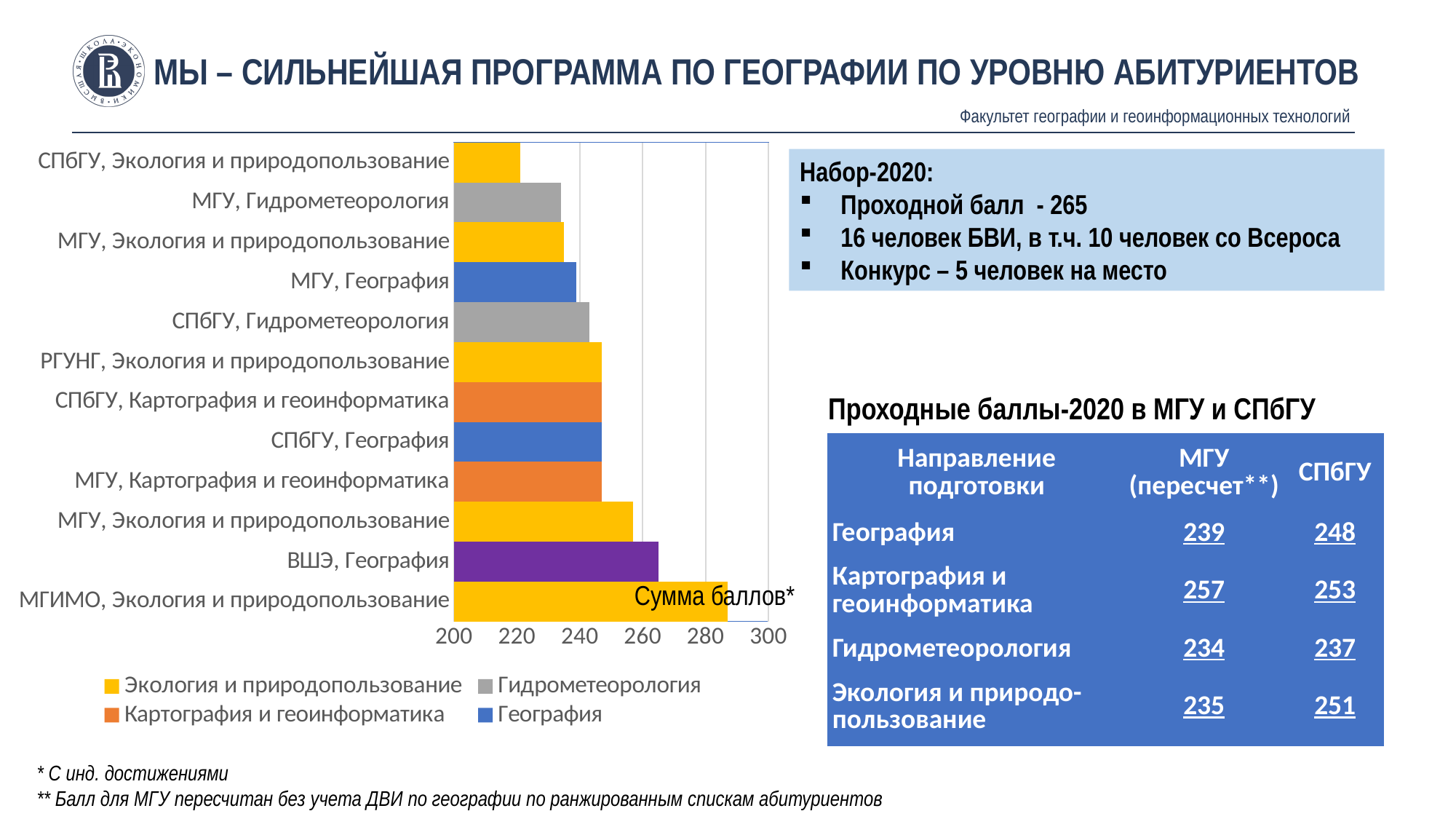
How many series does the chart legend list? 4 Is the value for СПбГУ, Экология и природопользование greater or less than 240? less Which legend entry is shown in grey? Гидрометеорология Which category has the highest value in the chart? МГИМО, Экология и природопользование Is the value for ВШЭ, География greater or less than 260? greater How many bars (categories) does the chart show? 12 Is the value for МГУ, Гидрометеорология greater or less than 240? less What label is printed on the chart's value axis? Сумма баллов* Which is larger: the value for ВШЭ, География or the value for МГУ, География? ВШЭ, География Which category has the lowest value in the chart? СПбГУ, Экология и природопользование What kind of chart is shown on the slide? bar chart